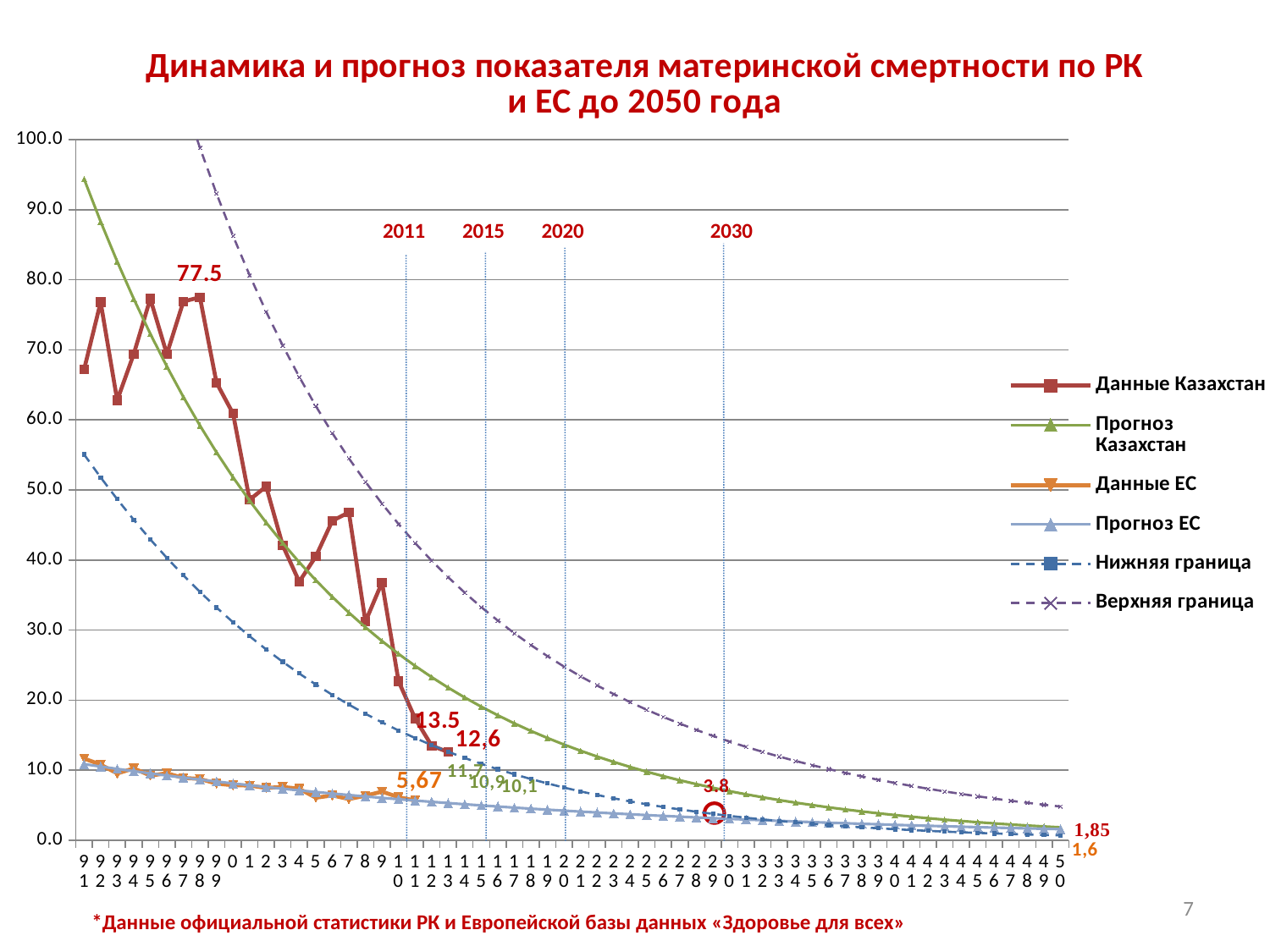
What value is labelled for the Данные Казахстан series at the 2011 marker line? 13.5 What is the difference between the labelled peak value 77.5 and the 2011 value 13.5 of the Данные Казахстан series? 64.0 What value is labelled at the right end (2050) of the Прогноз Казахстан series? 1,85 What value is circled at the 2030 marker line? 3,8 Does the Данные Казахстан series overall rise or fall along the x axis? fall What kind of chart is shown on the slide? line chart What value is labelled for the Данные ЕС series near the 2011 marker line? 5,67 At the 2011 marker line, which is larger: the Данные Казахстан value or the Данные ЕС value? Данные Казахстан How many series does the legend list? 6 What is the highest labelled value of the Данные Казахстан series? 77.5 What value is labelled at the right end (2050) of the Прогноз ЕС series? 1,6 Is the value of the Прогноз Казахстан series at the 2020 marker line greater or less than 20.0? less